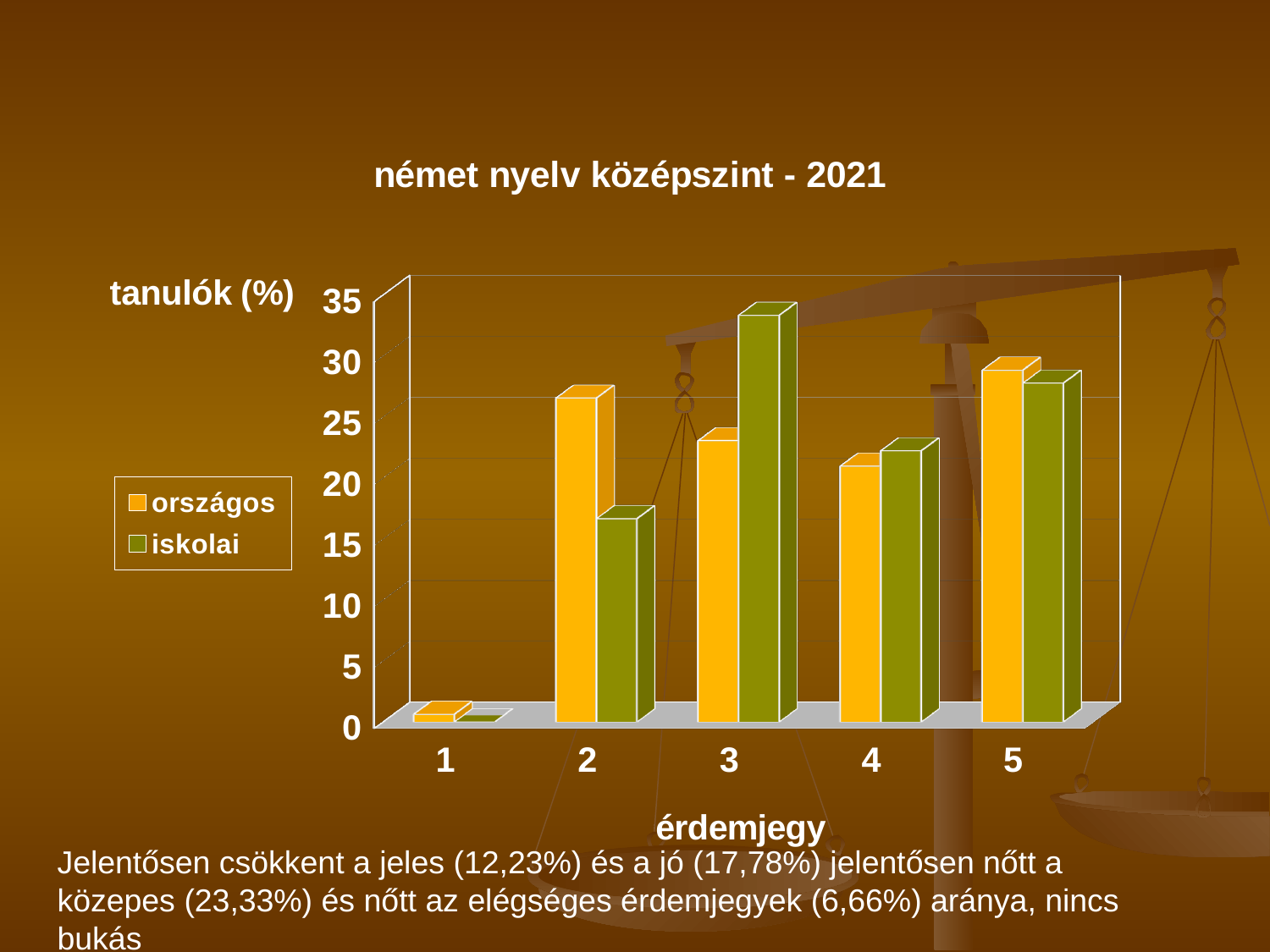
How many series does the legend list? 2 Is the iskolai value for grade 3 greater or less than 30? greater What kind of chart is shown on the slide? bar chart For which grade is the országos value lowest? 1 What are the two series named in the legend? országos, iskolai What is the title of the chart? német nyelv középszint - 2021 Is the iskolai value for grade 2 greater or less than 20? less How many grade categories (érdemjegy) are shown on the x axis? 5 For grade 3, which series has the larger value, országos or iskolai? iskolai For which grade is the iskolai value highest? 3 For grade 2, which series has the larger value, országos or iskolai? országos Is the országos value for grade 2 greater or less than 25? greater